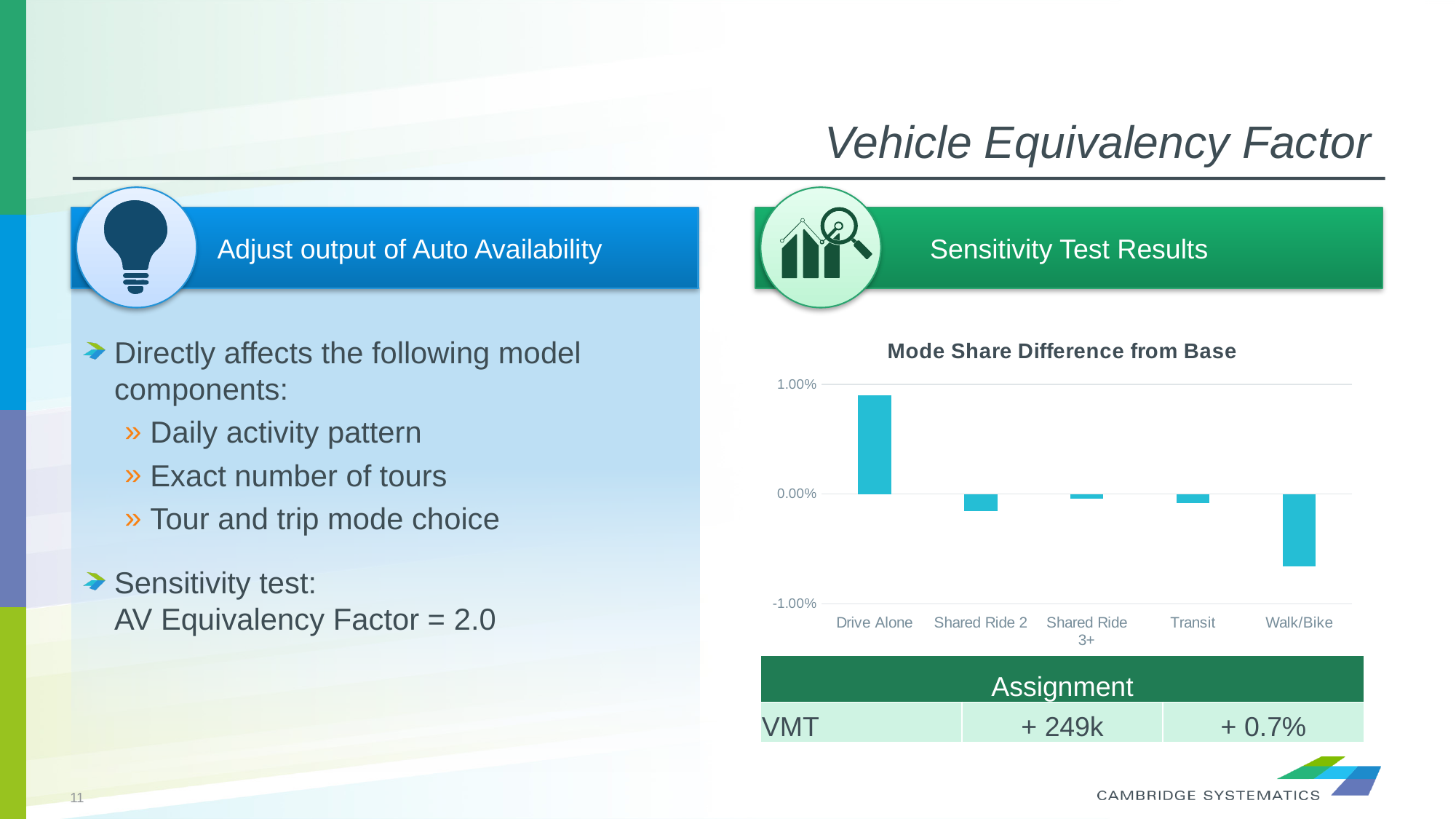
How many categories are shown on the x axis of the "Mode Share Difference from Base" chart? 5 What kind of chart is "Mode Share Difference from Base"? bar chart In the "Mode Share Difference from Base" chart, which has the larger decrease from base: Shared Ride 2 or Walk/Bike? Walk/Bike In the "Mode Share Difference from Base" chart, is the value for Walk/Bike greater or less than 0.00%? less In the "Mode Share Difference from Base" chart, is the value for Drive Alone greater or less than 0.00%? greater What is the title of the chart on the slide? Mode Share Difference from Base Which category has the lowest value in the "Mode Share Difference from Base" chart? Walk/Bike Which category has the highest value in the "Mode Share Difference from Base" chart? Drive Alone In the "Mode Share Difference from Base" chart, is the value for Walk/Bike greater or less than -1.00%? greater In the "Mode Share Difference from Base" chart, which value is larger: Drive Alone or Transit? Drive Alone How many categories in the "Mode Share Difference from Base" chart have a negative value? 4